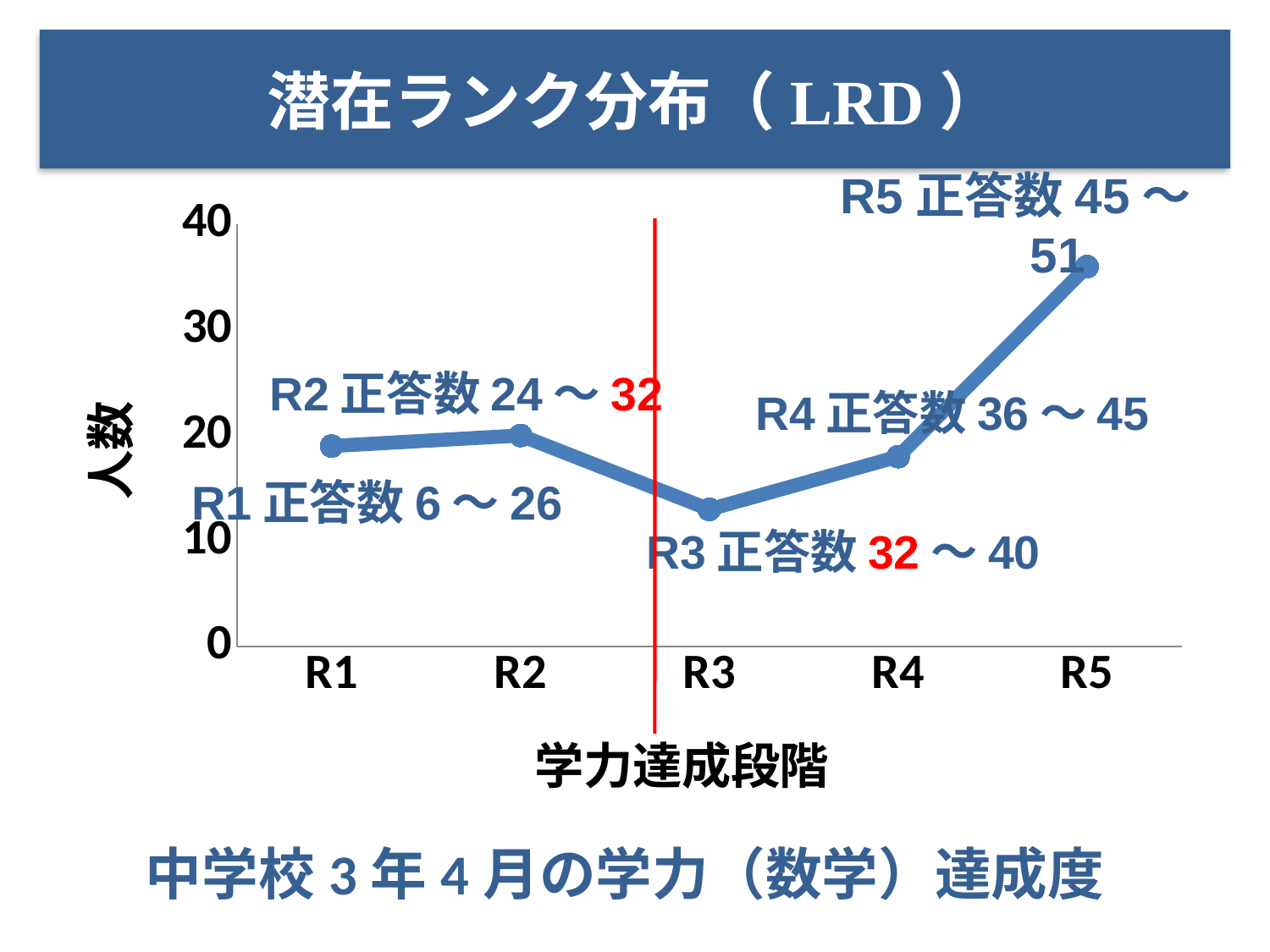
Which category has the lowest value? R3 Which category has the highest value? R5 What is the title of the chart? 潜在ランク分布（LRD） Which is larger, the value for R3 or the value for R5? R5 Do the values rise or fall from R3 to R5? rise Is the value for R3 greater or less than 20? less Is the value for R5 greater or less than 30? greater Which is larger, the value for R2 or the value for R3? R2 How many categories are plotted along the x axis? 5 What is the label of the y axis? 人数 What kind of chart is shown on the slide? line chart Is the value for R3 greater or less than 10? greater